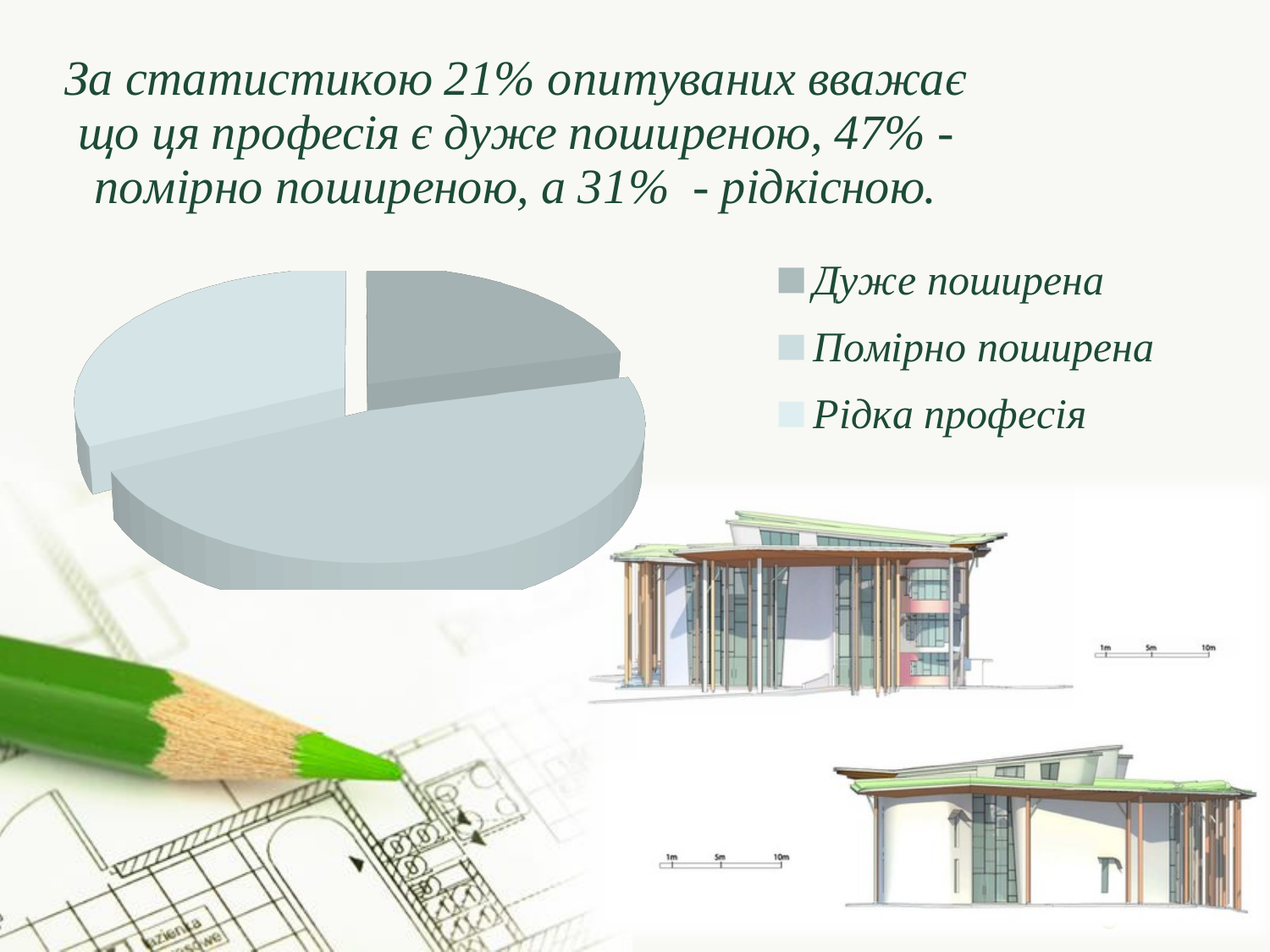
How many slices does the pie chart have? 3 What share of respondents consider the profession "Дуже поширена"? 21% Which category has the smallest slice of the pie chart? Дуже поширена Which legend entry is listed first in the chart legend? Дуже поширена Which slice is larger: "Рідка професія" or "Дуже поширена"? Рідка професія What is the difference in percentage points between "Рідка професія" and "Дуже поширена"? 10% What share of respondents consider the profession "Помірно поширена"? 47% What is the difference in percentage points between "Помірно поширена" and "Дуже поширена"? 26% Which category has the largest slice of the pie chart? Помірно поширена What share of respondents consider the profession "Рідка професія"? 31% What kind of chart is shown on the slide? pie chart How many entries does the chart legend list? 3